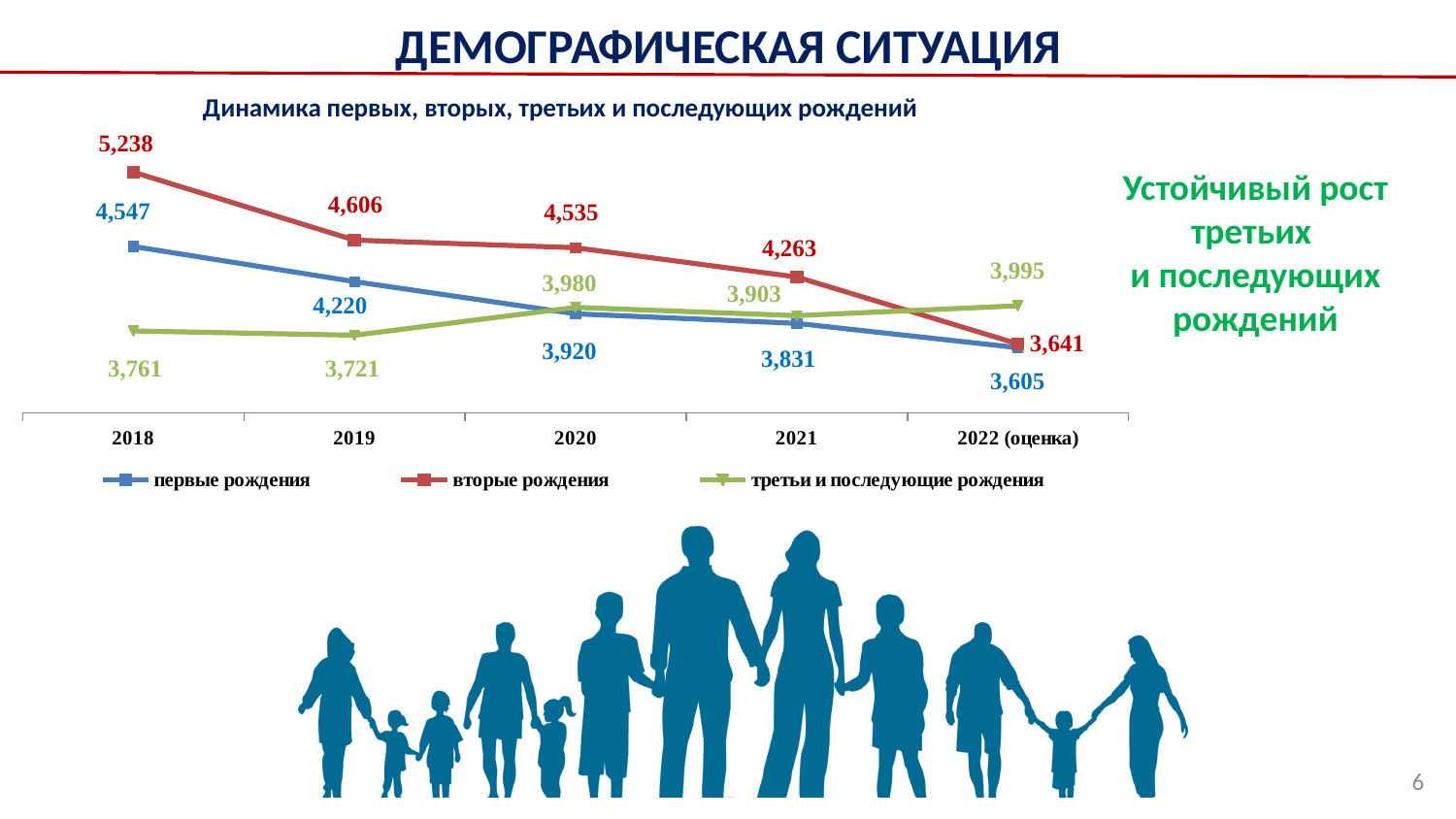
In which year is the value for первые рождения the lowest? 2022 (оценка) What is the difference between вторые рождения and первые рождения in 2018? 691 What is the value for вторые рождения in 2018? 5,238 What is the title of the chart? Динамика первых, вторых, третьих и последующих рождений In which year is the value for третьи и последующие рождения the highest? 2022 (оценка) What is the value for третьи и последующие рождения in 2022 (оценка)? 3,995 What type of chart is shown on the slide? line chart What is the value for первые рождения in 2020? 3,920 Does the value for вторые рождения rise or fall from 2018 to 2022 (оценка)? fall Which is larger in 2021: третьи и последующие рождения or первые рождения? третьи и последующие рождения How many years (points) are plotted along the x axis? 5 How many series does the legend list? 3